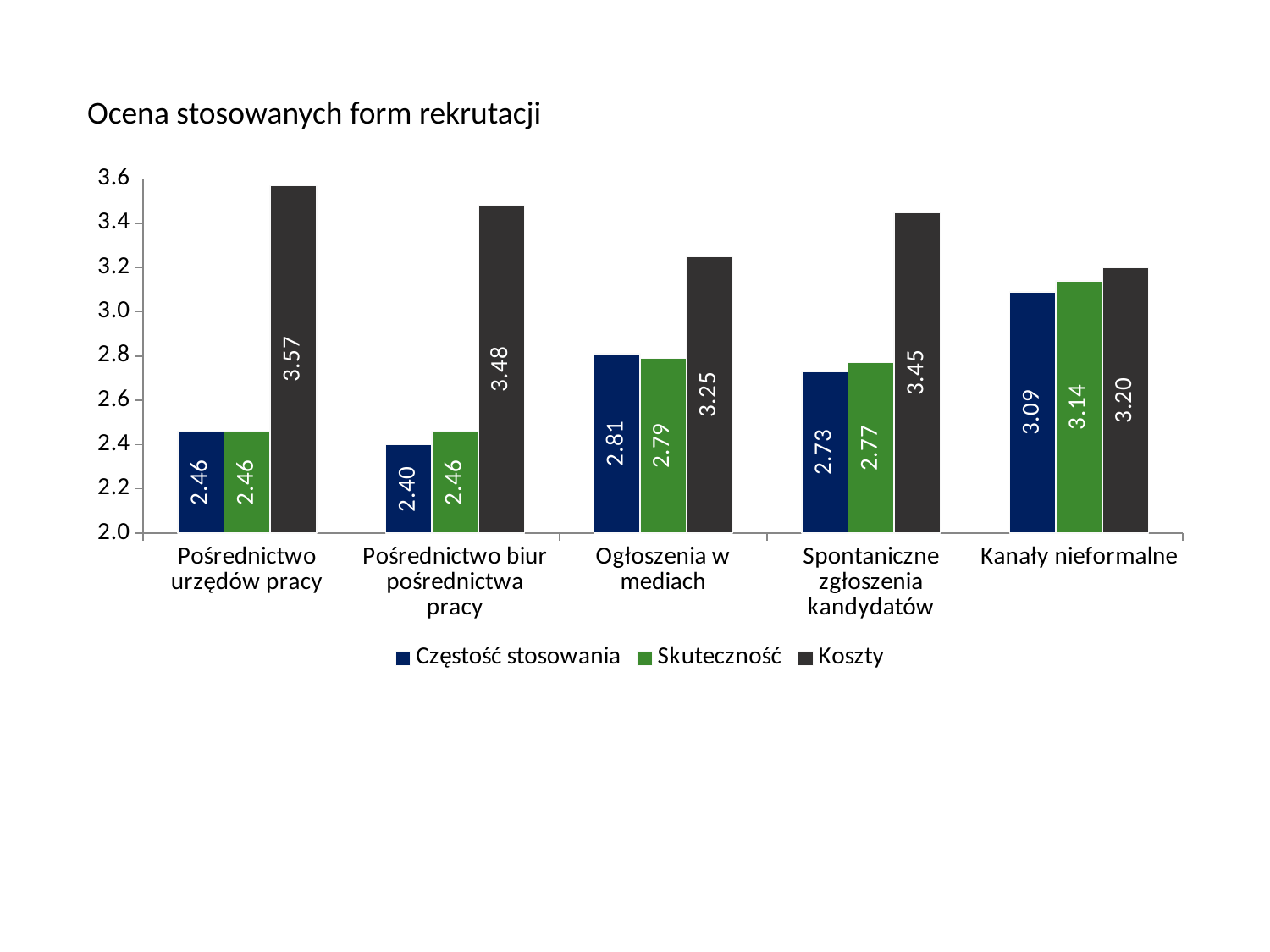
What is the Częstość stosowania value for Kanały nieformalne? 3.09 Which category has the highest Koszty value? Pośrednictwo urzędów pracy What kind of chart is shown? Bar chart What is the Koszty value for Pośrednictwo urzędów pracy? 3.57 What is the difference between the Koszty and Skuteczność values for Ogłoszenia w mediach? 0.46 Is the Koszty value for Spontaniczne zgłoszenia kandydatów greater or less than 3.0? greater What is the title of the chart? Ocena stosowanych form rekrutacji How many series does the legend list? 3 What is the Skuteczność value for Spontaniczne zgłoszenia kandydatów? 2.77 Which is larger for Kanały nieformalne: Częstość stosowania or Skuteczność? Skuteczność Which category has the lowest Częstość stosowania value? Pośrednictwo biur pośrednictwa pracy How many categories are shown on the x axis? 5